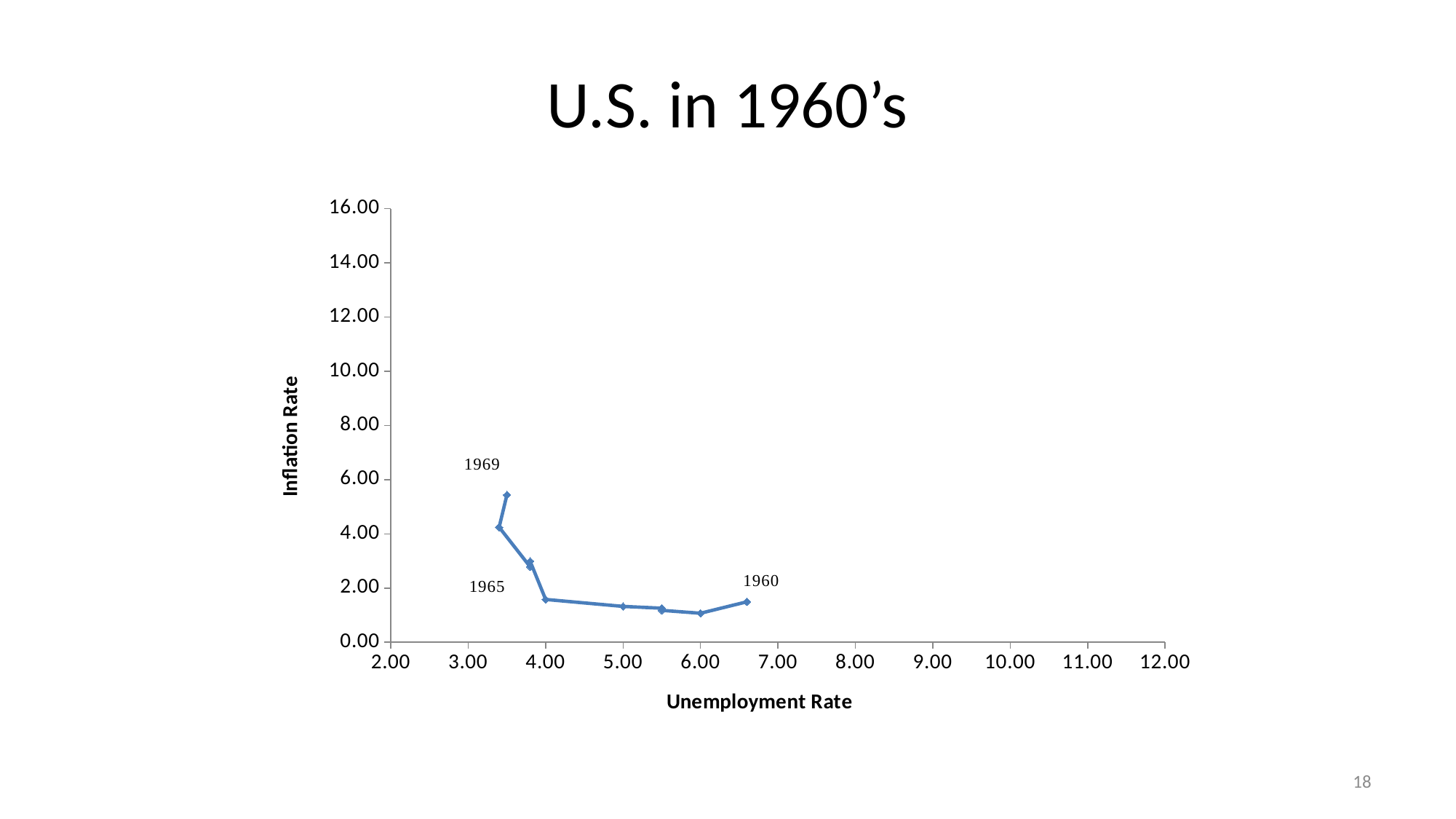
Which labelled year, 1960 or 1969, has the higher inflation rate? 1969 Is the inflation rate for the point labelled 1969 greater or less than 4.00? greater What kind of chart is shown on the slide? line chart As the unemployment rate increases along the x axis, does the inflation rate generally rise or fall? fall Is the unemployment rate for the point labelled 1960 greater or less than 6.00? greater Which labelled year, 1960 or 1969, has the higher unemployment rate? 1960 What is the highest value shown on the vertical axis? 16.00 Which labelled year has the highest inflation rate on the chart? 1969 What is the label of the vertical axis? Inflation Rate Is the inflation rate for the point labelled 1960 greater or less than 2.00? less What is the title of the chart? U.S. in 1960's